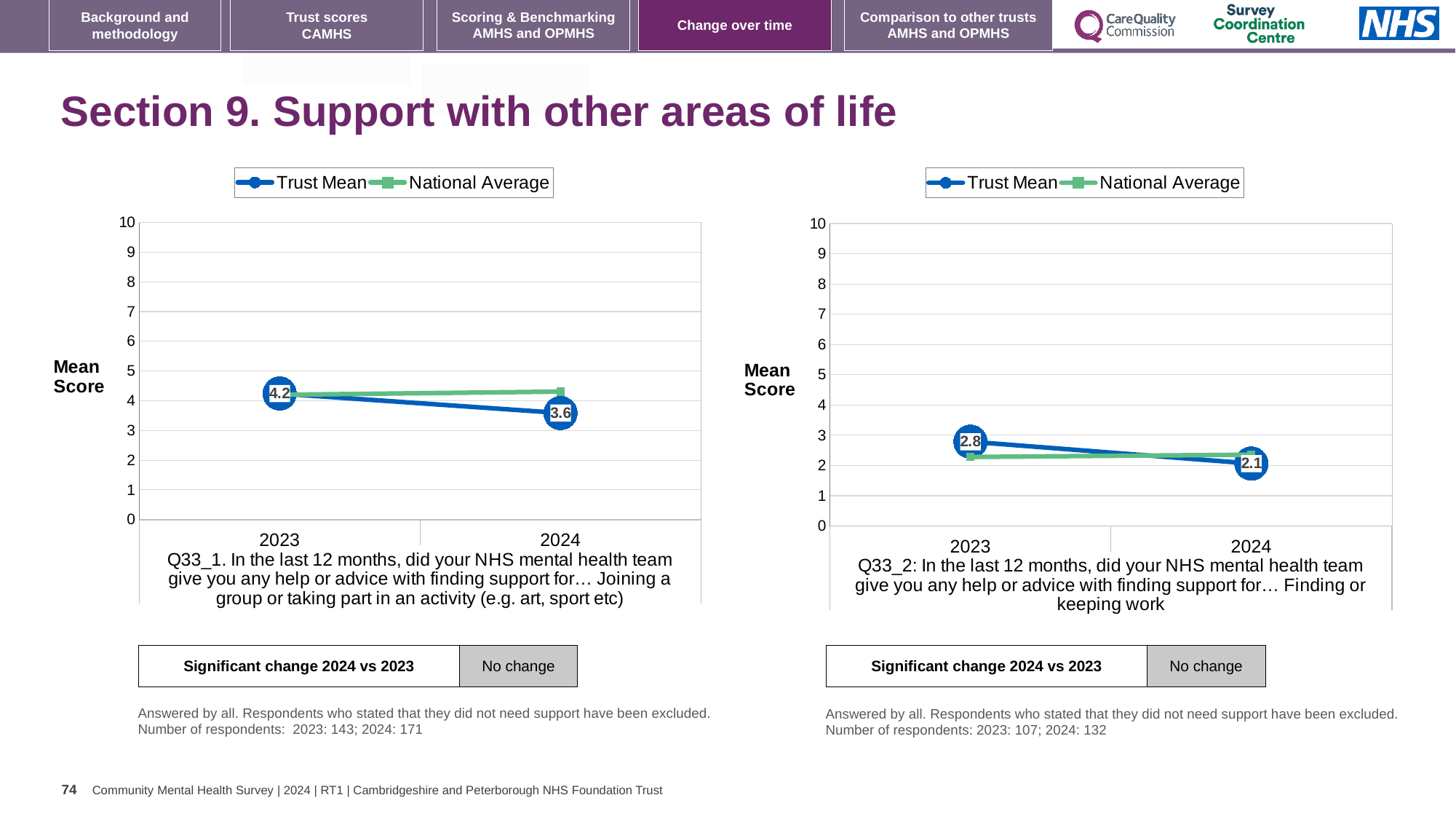
In the left chart (Q33_1), what is the Trust Mean score for 2024? 3.6 In the right chart (Q33_2), what is the Trust Mean score for 2023? 2.8 In the right chart (Q33_2), what is the difference between the Trust Mean in 2023 and in 2024? 0.7 In the left chart (Q33_1), by how much did the Trust Mean fall from 2023 to 2024? 0.6 In the right chart (Q33_2), what is the Trust Mean score for 2024? 2.1 In the right chart (Q33_2), which year has the higher Trust Mean, 2023 or 2024? 2023 What type of chart is the right chart (Q33_2)? line chart In the left chart (Q33_1), what is the Trust Mean score for 2023? 4.2 How many series does the legend of the left chart (Q33_1) list? 2 In the right chart (Q33_2), is the National Average value for 2023 greater or less than 3? less In the left chart (Q33_1), is the National Average value for 2024 greater or less than 3? greater In the left chart (Q33_1), does the Trust Mean rise or fall from 2023 to 2024? fall